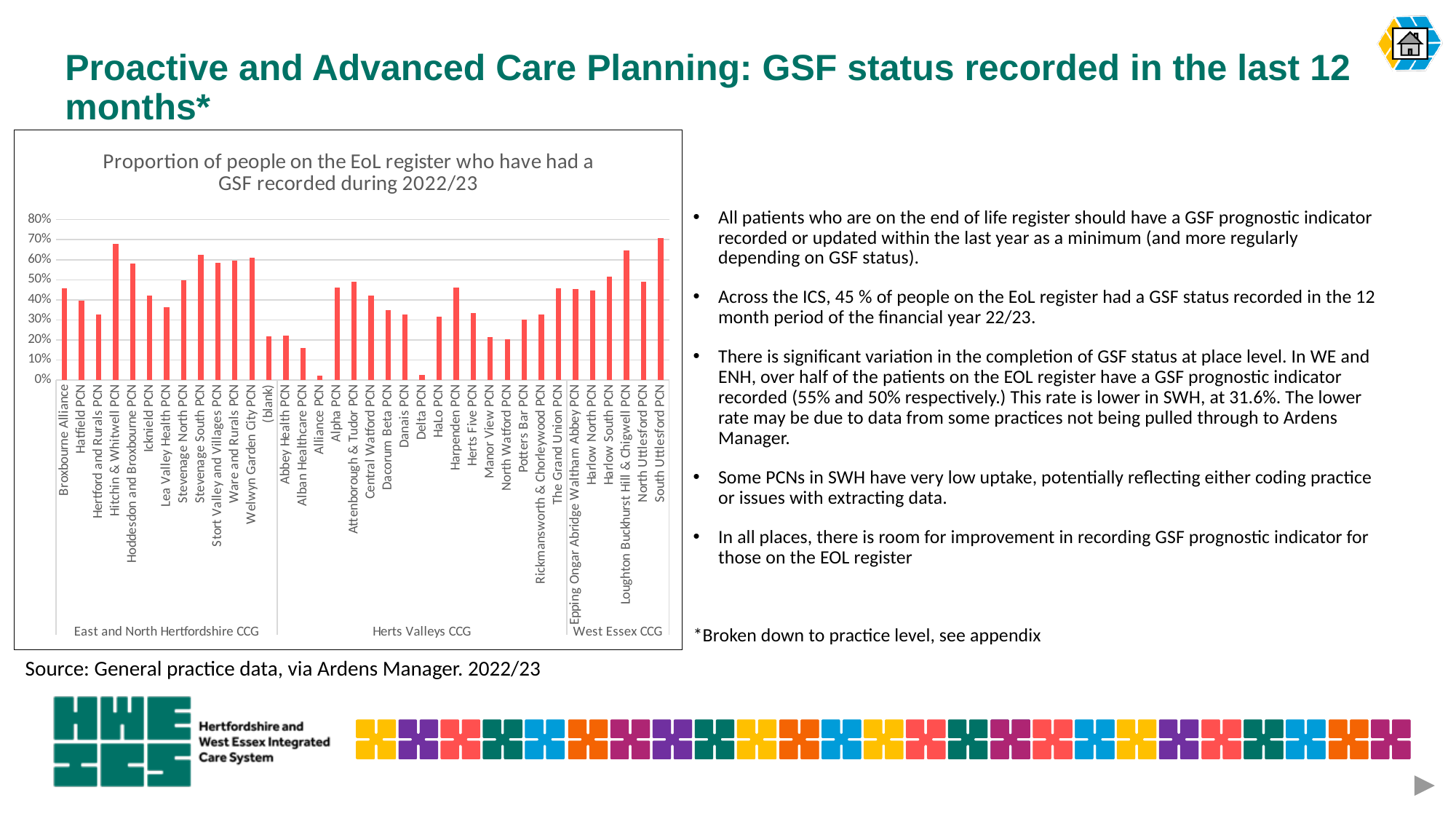
How many CCG groups are the PCNs divided into along the x axis of the chart? 3 Which has the larger value, Hitchin & Whitwell PCN or Hertford and Rurals PCN? Hitchin & Whitwell PCN How many PCN bars are plotted in the chart in total? 36 Is the value for Loughton Buckhurst Hill & Chigwell PCN greater or less than 60%? greater Is the value for Potters Bar PCN greater or less than 40%? less What kind of chart is shown on the slide? Bar chart Is the value for Alban Healthcare PCN greater or less than 20%? less What is the highest value shown on the chart's vertical axis? 80% What is the title of the chart? Proportion of people on the EoL register who have had a GSF recorded during 2022/23 Which PCN has the highest proportion in the chart? South Uttlesford PCN Which has the larger value, Alpha PCN or Alban Healthcare PCN? Alpha PCN